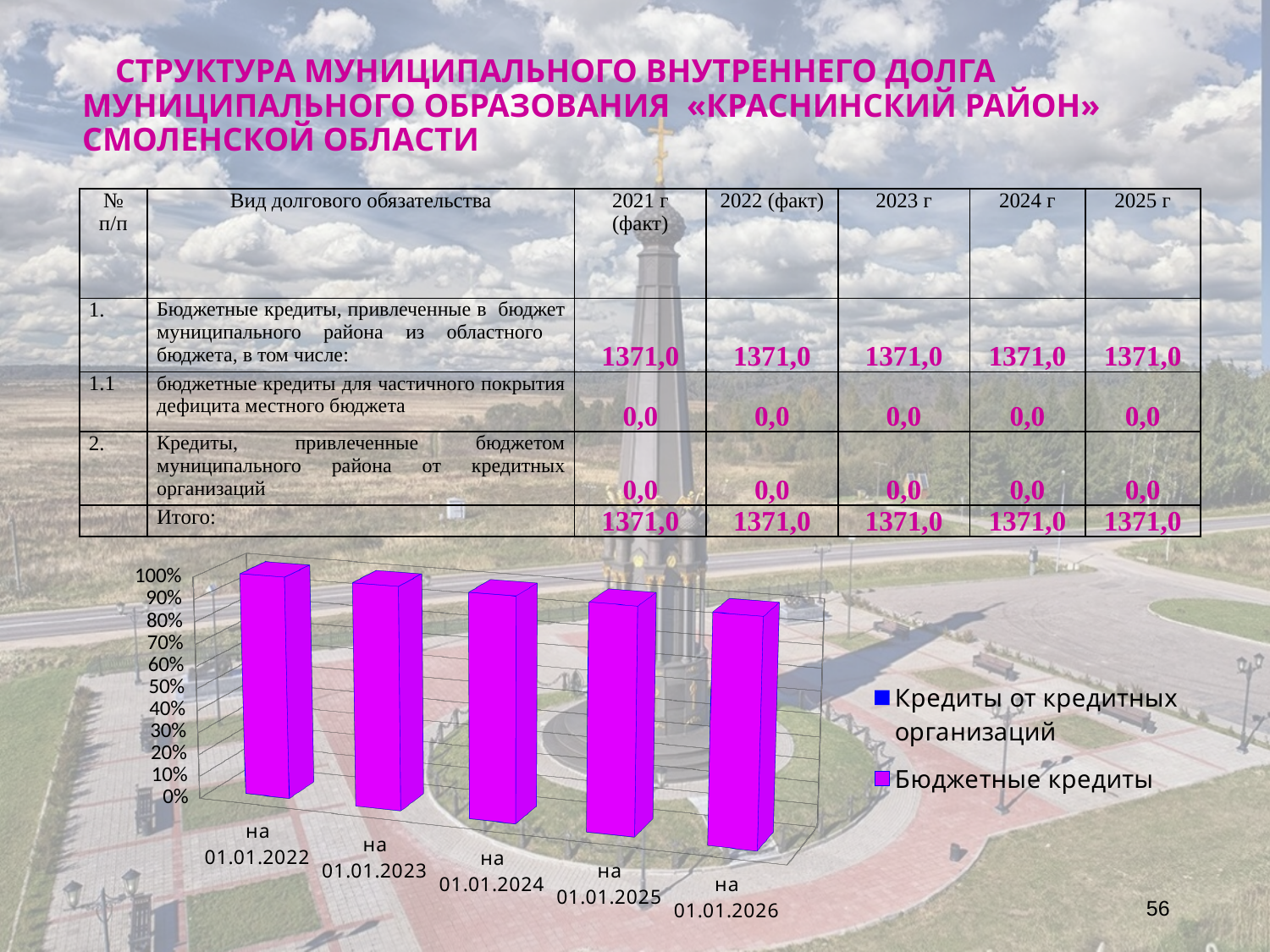
What is the first category label on the x axis of the chart? на 01.01.2022 Which series fills the entire bar for each date in the chart? Бюджетные кредиты What are the two series named in the chart legend? Кредиты от кредитных организаций; Бюджетные кредиты What is the last category label on the x axis of the chart? на 01.01.2026 What colour are the bars for Бюджетные кредиты in the chart? magenta Is the value for Бюджетные кредиты on 01.01.2024 greater or less than 90%? greater What kind of chart is shown at the bottom of the slide? bar chart Is the value for Бюджетные кредиты on 01.01.2026 greater or less than 50%? greater How many series does the chart legend list? 2 What is the highest value shown on the chart's vertical axis? 100% Is the value for Бюджетные кредиты on 01.01.2022 greater or less than 50%? greater How many categories (dates) are shown on the x axis of the chart? 5